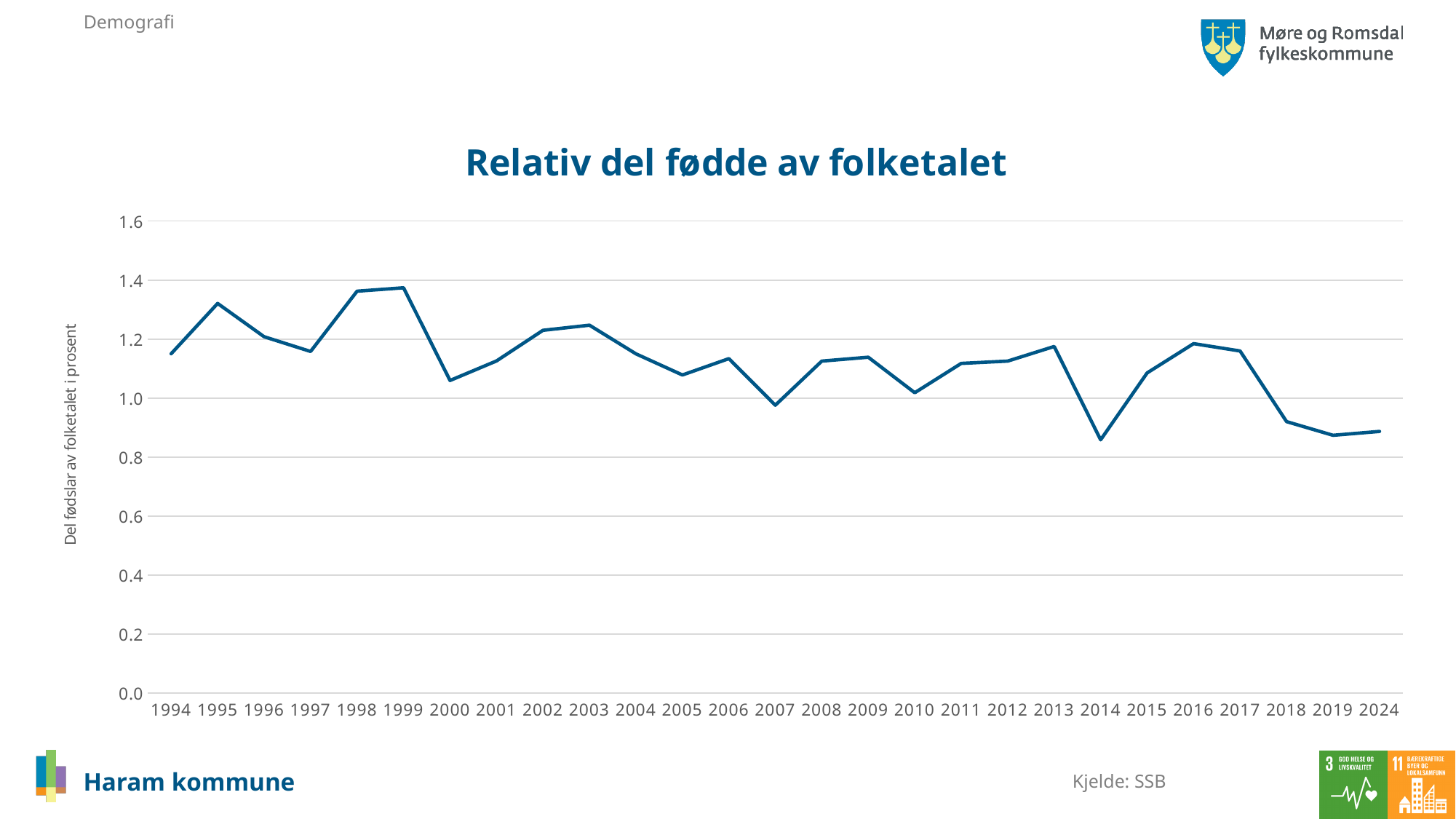
Which year has the larger value, 2013 or 2018? 2013 Is the value for 2016 greater or less than 1.0? greater Is the value for 2014 greater or less than 1.0? less Is the value for 2024 greater or less than 1.0? less What is the title of the chart? Relativ del fødde av folketalet How many years are plotted along the x axis of the chart? 27 What is the label on the vertical axis of the chart? Del fødslar av folketalet i prosent What kind of chart is shown on the slide? line chart Which year has the larger value, 1995 or 2014? 1995 Overall, does the value rise or fall from 1994 to 2024? fall